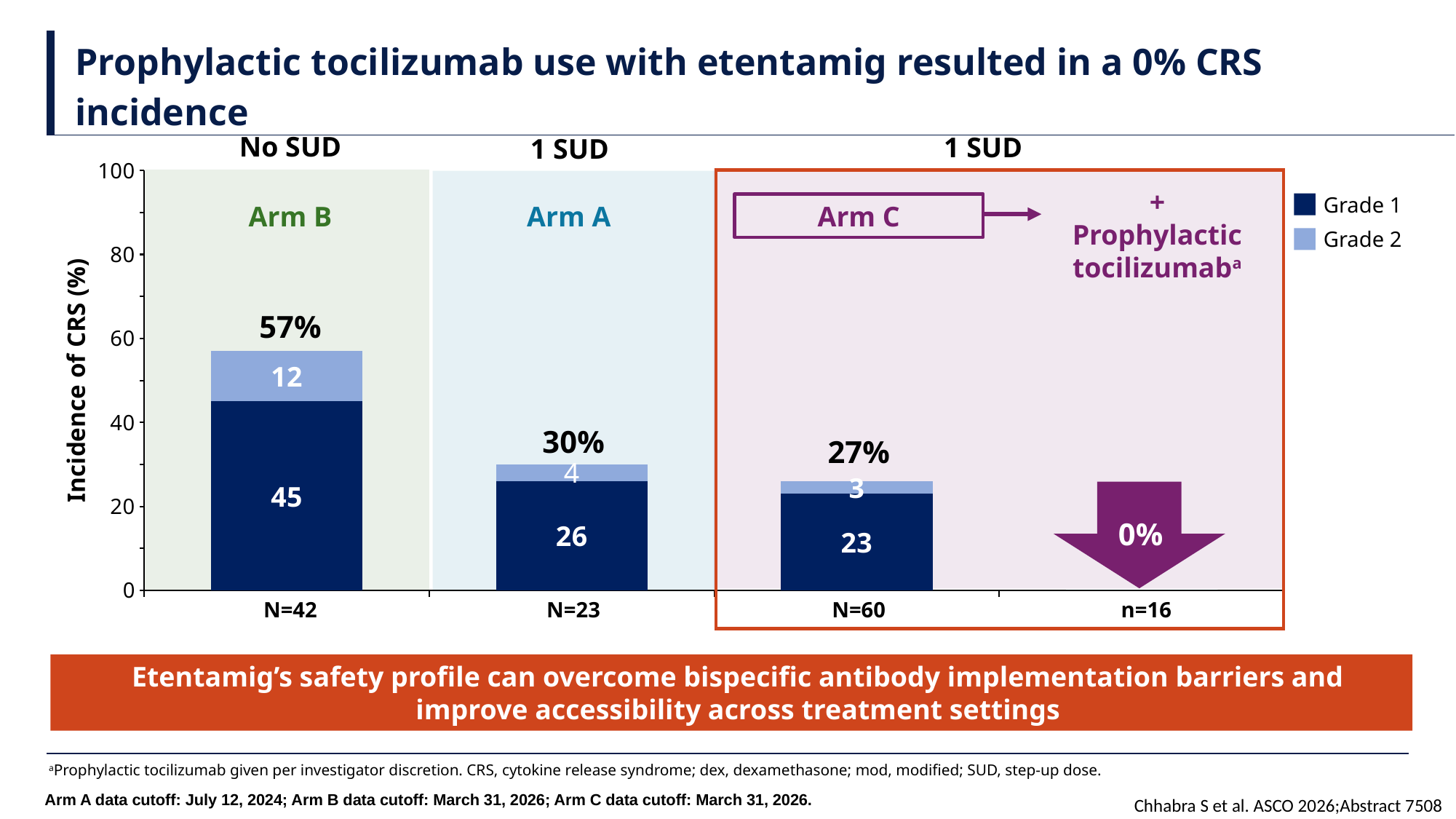
What is the difference in total CRS incidence between Arm B and Arm A? 27% What is the Grade 1 value printed on the Arm C bar? 23 What is the total CRS incidence shown for Arm C (N=60)? 27% What kind of chart is shown on the slide? Stacked bar chart What is the total CRS incidence shown for Arm A? 30% Which arm has the highest total CRS incidence? Arm B What is the Grade 2 value printed on the Arm A bar? 4 What is the Grade 1 value printed on the Arm B bar? 45 How many series does the legend list? 2 What is the total CRS incidence shown for Arm B? 57% What CRS incidence is shown for Arm C with prophylactic tocilizumab (n=16)? 0% Which is larger, the Grade 2 value for Arm B or the Grade 2 value for Arm C? Arm B